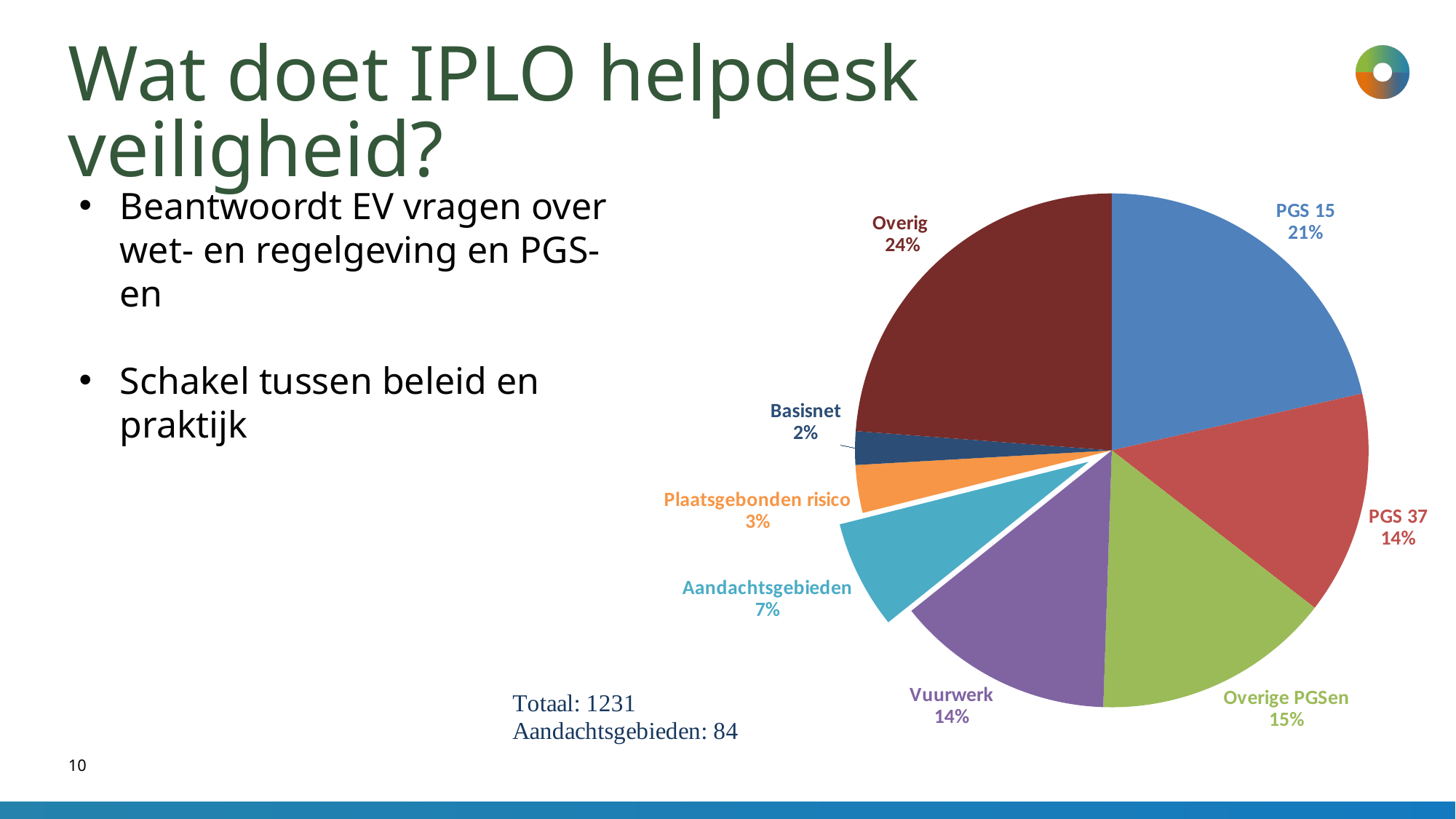
What is the difference in percentage points between Overig and PGS 15? 3 What percentage is shown for Overig? 24% What kind of chart is shown on the slide? pie chart How many categories (slices) does the pie chart have? 8 Which is larger, the share for Overige PGSen or the share for Vuurwerk? Overige PGSen Which category has the largest share of the pie? Overig What percentage is shown for Basisnet? 2% What percentage is shown for Aandachtsgebieden? 7% Which slice is pulled out (exploded) from the pie? Aandachtsgebieden What percentage is shown for Plaatsgebonden risico? 3% What share of the pie does PGS 15 represent? 21% Which category has the smallest share of the pie? Basisnet